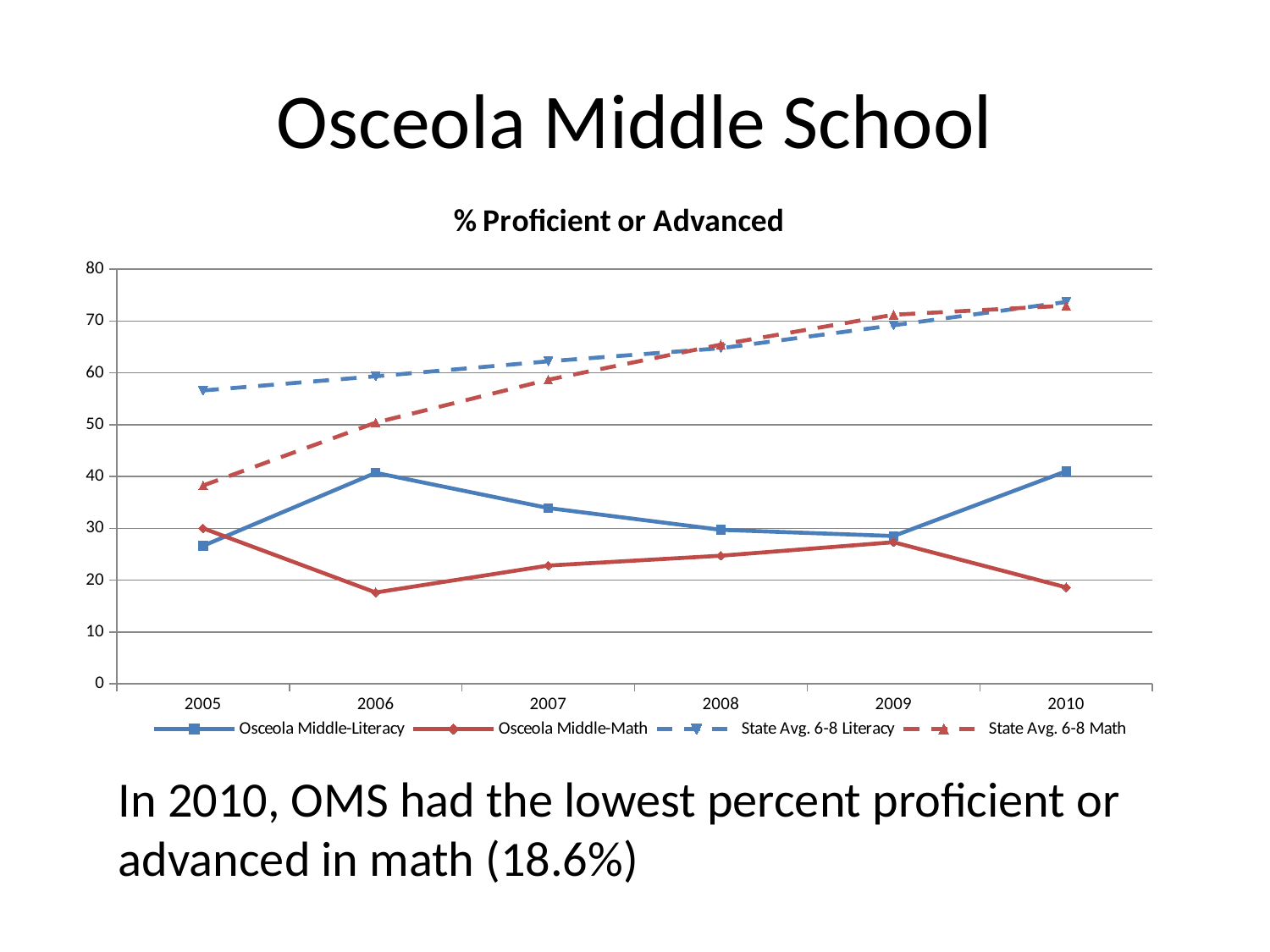
How many years are plotted along the x axis? 6 Is the value for State Avg. 6-8 Math in 2005 greater or less than 40? less What kind of chart is shown on the slide? line chart Is the value for Osceola Middle-Math in 2006 greater or less than 20? less Is the value for Osceola Middle-Literacy in 2006 greater or less than 30? greater In 2010, which is higher: State Avg. 6-8 Literacy or Osceola Middle-Literacy? State Avg. 6-8 Literacy Does the State Avg. 6-8 Math line rise or fall from 2005 to 2010? rise Does the State Avg. 6-8 Literacy line rise or fall from 2005 to 2010? rise What is the title of the chart? % Proficient or Advanced What was Osceola Middle School's percent proficient or advanced in math in 2010? 18.6% How many series does the legend list? 4 Which series has the highest value in 2005? State Avg. 6-8 Literacy